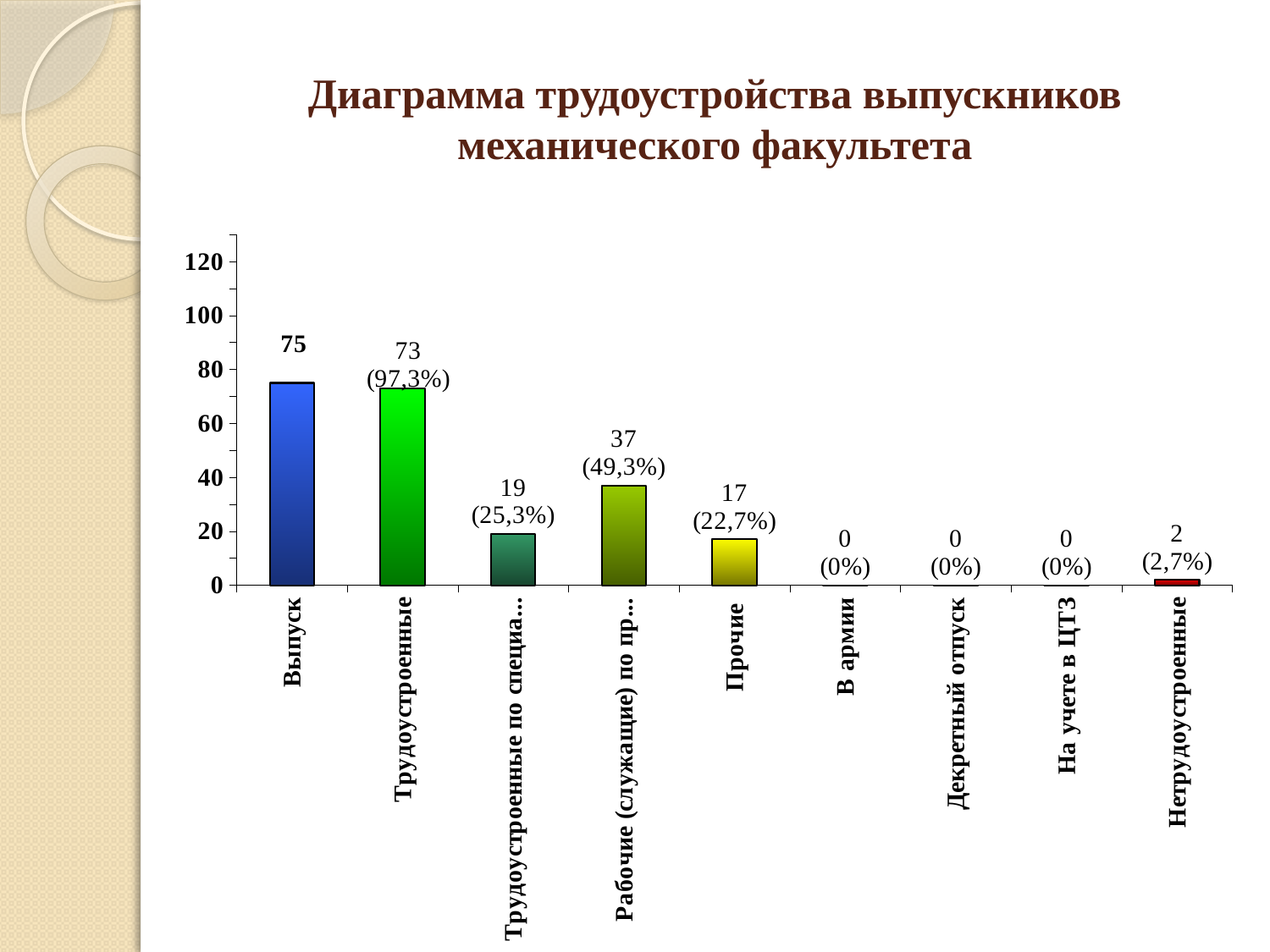
What is the value for Прочие? 17 What kind of chart is shown on the slide? Bar chart How many categories are shown on the x axis? 9 What is the difference between the values for Выпуск and Трудоустроенные? 2 What percentage is shown for Трудоустроенные? 97,3% What is the value for Трудоустроенные? 73 What is the value for В армии? 0 What percentage is shown for Нетрудоустроенные? 2,7% Which category has the highest value? Выпуск Which is larger, the value for Прочие or the value for Нетрудоустроенные? Прочие What is the value for Нетрудоустроенные? 2 What is the value for Выпуск? 75